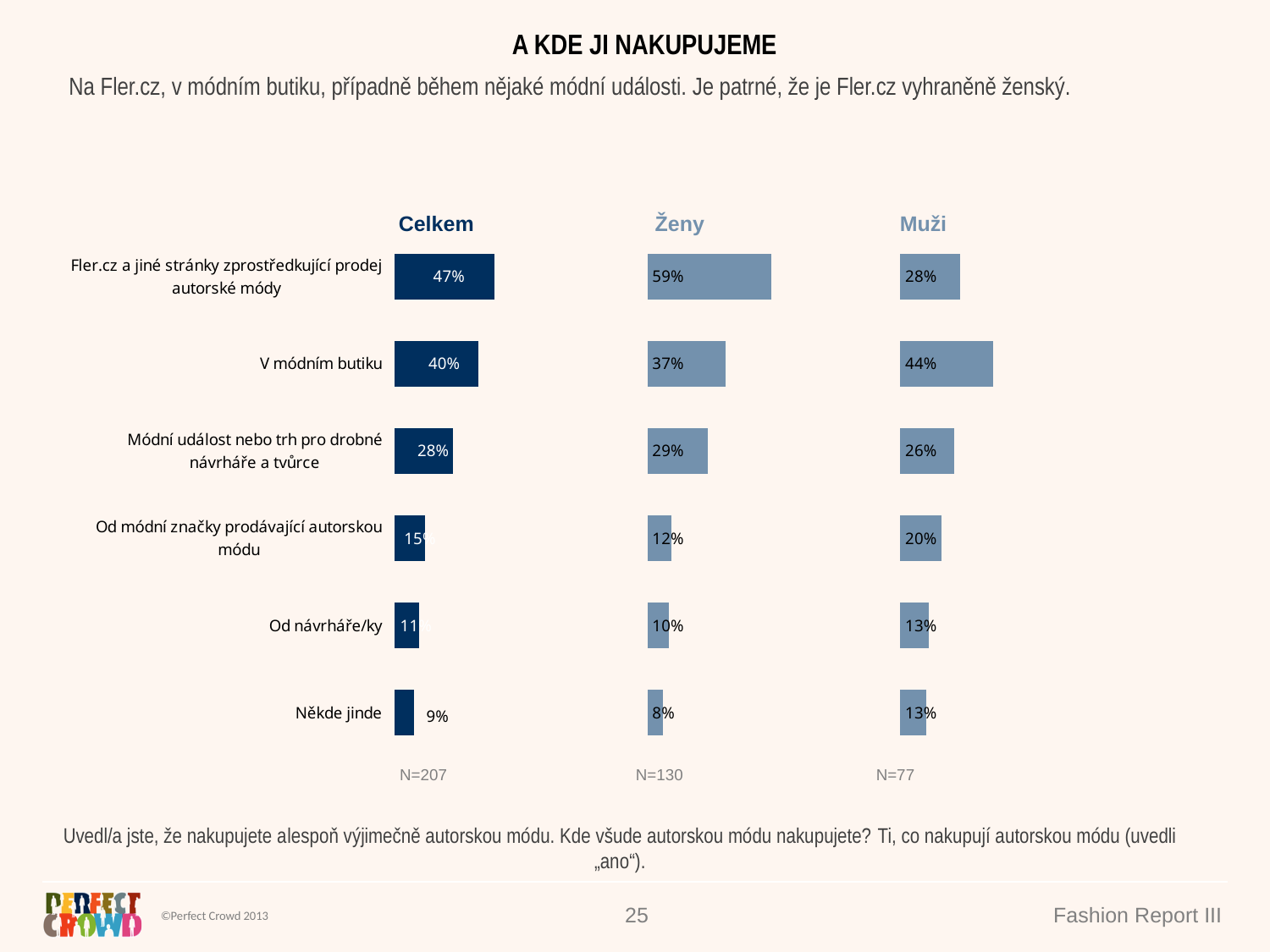
How many categories are shown in the Celkem chart? 6 In the Muži chart, what is the value for 'Někde jinde'? 13% In the Muži chart, what is the value for 'V módním butiku'? 44% What is the sample size (N) shown under the Ženy chart? N=130 In the Ženy chart, which category has the lowest value? Někde jinde In the Celkem chart, which category has the highest value? Fler.cz a jiné stránky zprostředkující prodej autorské módy What is the difference between the Ženy and Muži values for 'Fler.cz a jiné stránky zprostředkující prodej autorské módy'? 31 percentage points Which is larger: the Ženy value or the Muži value for 'Od módní značky prodávající autorskou módu'? Muži What kind of chart is used on this slide? Bar chart In the Ženy chart, what is the value for 'Fler.cz a jiné stránky zprostředkující prodej autorské módy'? 59% In the Muži chart, which category has the highest value? V módním butiku In the Celkem chart, what is the value for 'Módní událost nebo trh pro drobné návrháře a tvůrce'? 28%